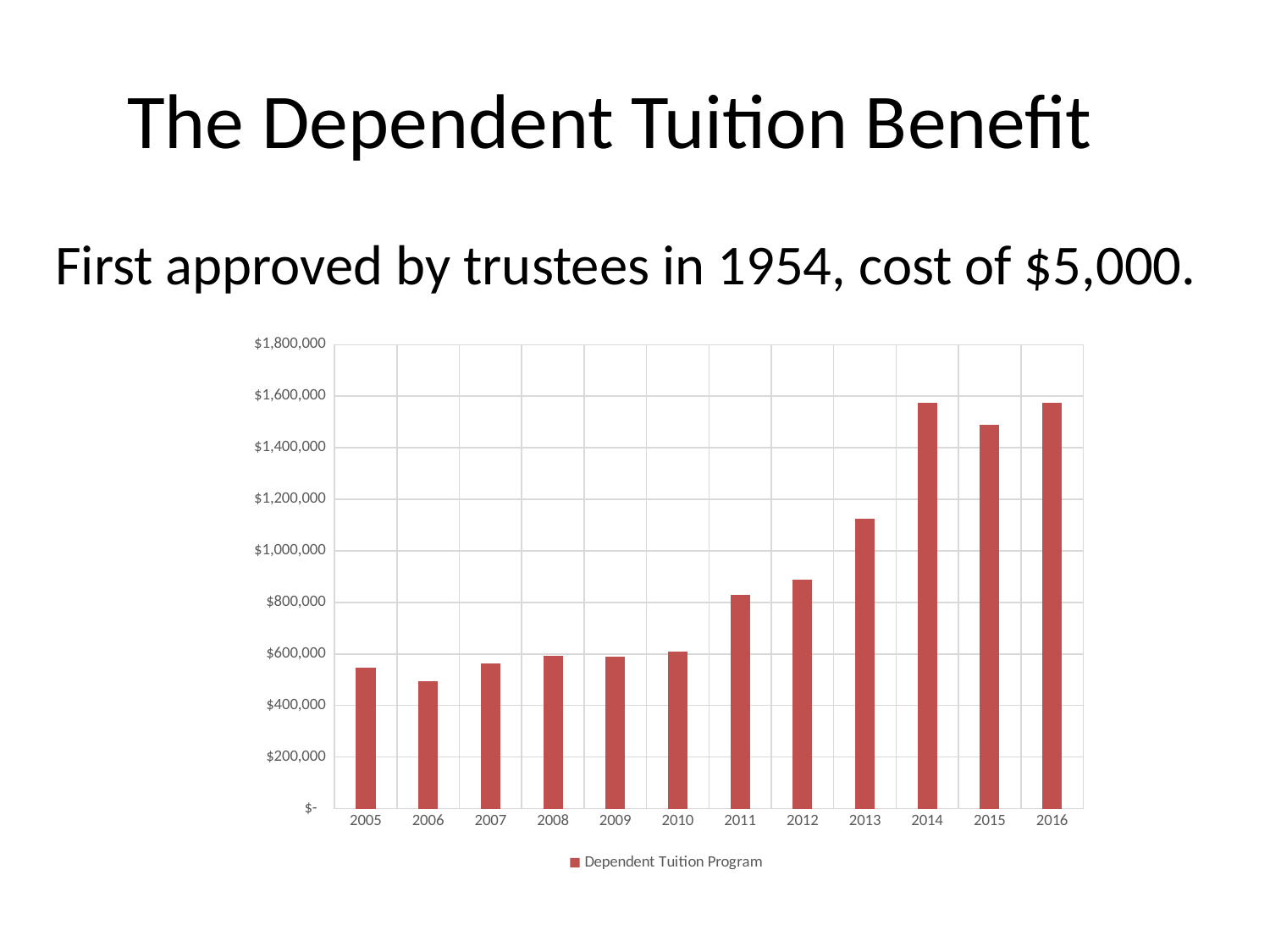
Is the value for 2006 greater or less than $600,000? less How many series does the chart legend list? 1 How many years are shown on the x axis of the chart? 12 Is the value for 2012 greater or less than $1,000,000? less Is the value for 2013 greater or less than $1,000,000? greater What kind of chart is shown on the slide? bar chart Which year has the lowest value in the chart? 2006 What is the name of the series shown in the chart legend? Dependent Tuition Program Do the values generally rise or fall from 2010 to 2014? rise Which is larger, the value for 2014 or the value for 2015? 2014